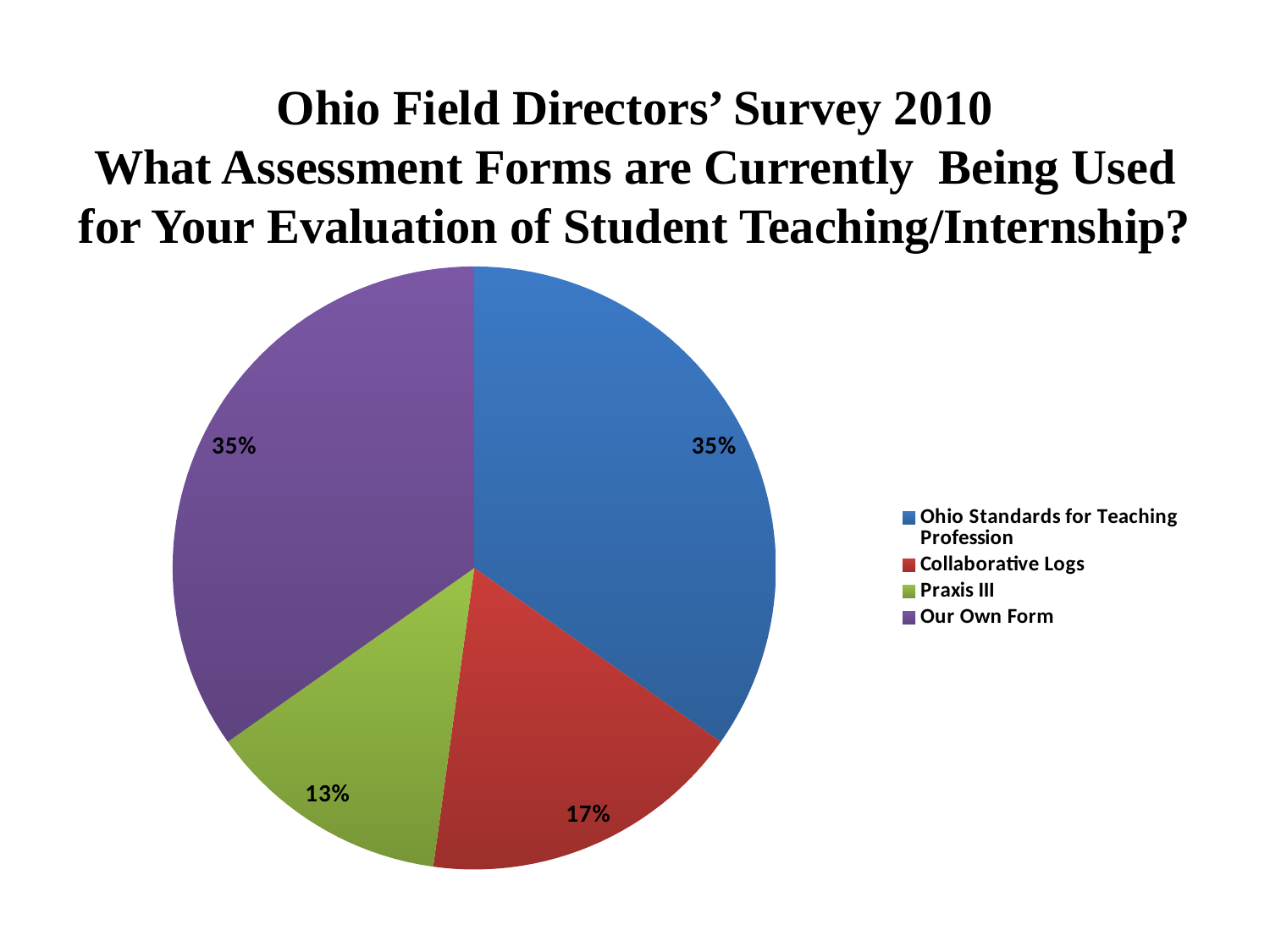
What kind of chart is shown on the slide? pie chart How many slices does the pie chart have? 4 What colour is the slice for Our Own Form? purple What share of the pie does Ohio Standards for Teaching Profession have? 35% What share of the pie does Our Own Form have? 35% What is the difference between the shares for Our Own Form and Collaborative Logs? 18% What share of the pie does Praxis III have? 13% Which category has the smallest slice of the pie? Praxis III Which is larger, the slice for Collaborative Logs or the slice for Praxis III? Collaborative Logs How many entries does the legend list? 4 What is the difference between the shares for Collaborative Logs and Praxis III? 4%